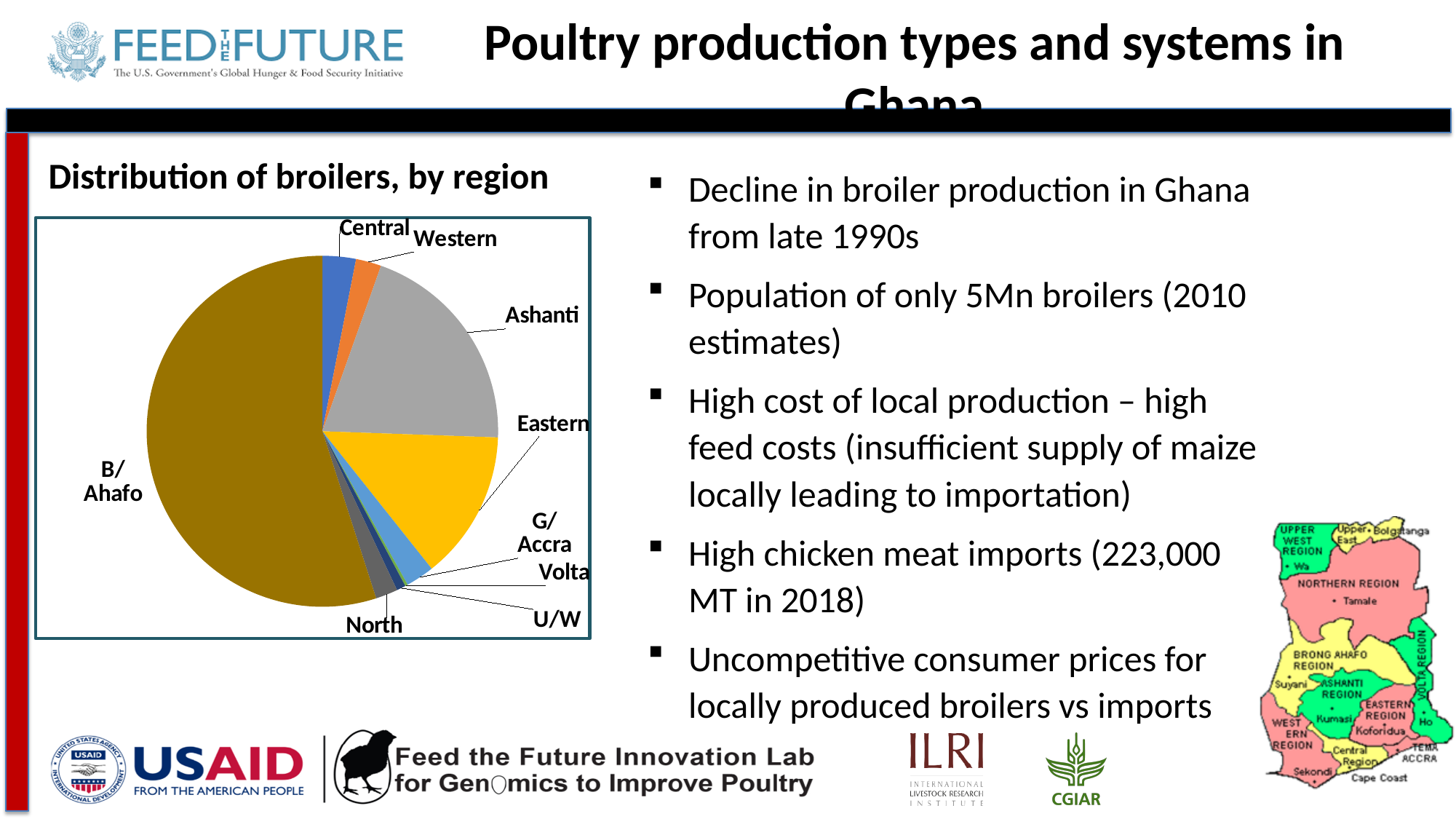
How many regions (slices) are shown in the pie chart? 9 Which region has the largest share of broilers in the pie chart? B/Ahafo What is the title of the chart on the slide? Distribution of broilers, by region Which region has the second-largest slice in the pie chart? Ashanti Which region has the larger slice, Ashanti or Western? Ashanti Which region has the larger slice, B/Ahafo or Ashanti? B/Ahafo What kind of chart is shown on the slide? pie chart Which region has the larger slice, Ashanti or Eastern? Ashanti Which region has the smallest slice in the pie chart? Volta Which region's slice is coloured grey in the pie chart? Ashanti